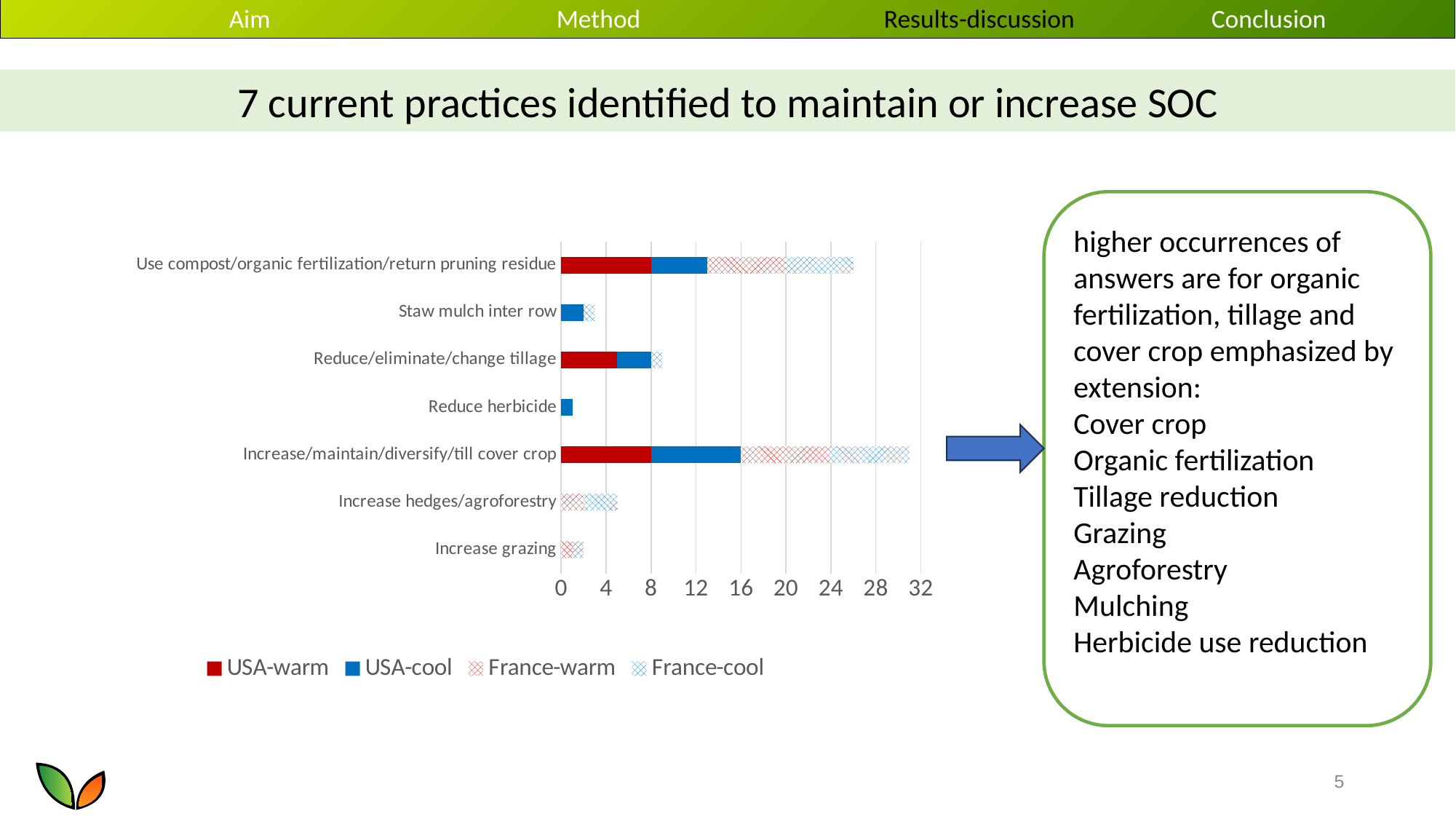
Which practice has the longest total bar on the chart? Increase/maintain/diversify/till cover crop What kind of chart is shown on the slide? bar chart How many series does the chart legend list? 4 Is the total bar for Reduce/eliminate/change tillage greater or less than 12? less Which has the longer total bar: Reduce/eliminate/change tillage or Increase hedges/agroforestry? Reduce/eliminate/change tillage Which has the longer total bar: Use compost/organic fertilization/return pruning residue or Increase/maintain/diversify/till cover crop? Increase/maintain/diversify/till cover crop What are the four series named in the chart legend? USA-warm, USA-cool, France-warm, France-cool How many practices (categories) are plotted on the chart? 7 Is the total bar for Use compost/organic fertilization/return pruning residue greater or less than 24? greater Is the total bar for Increase/maintain/diversify/till cover crop greater or less than 28? greater Which practice has the shortest total bar on the chart? Reduce herbicide